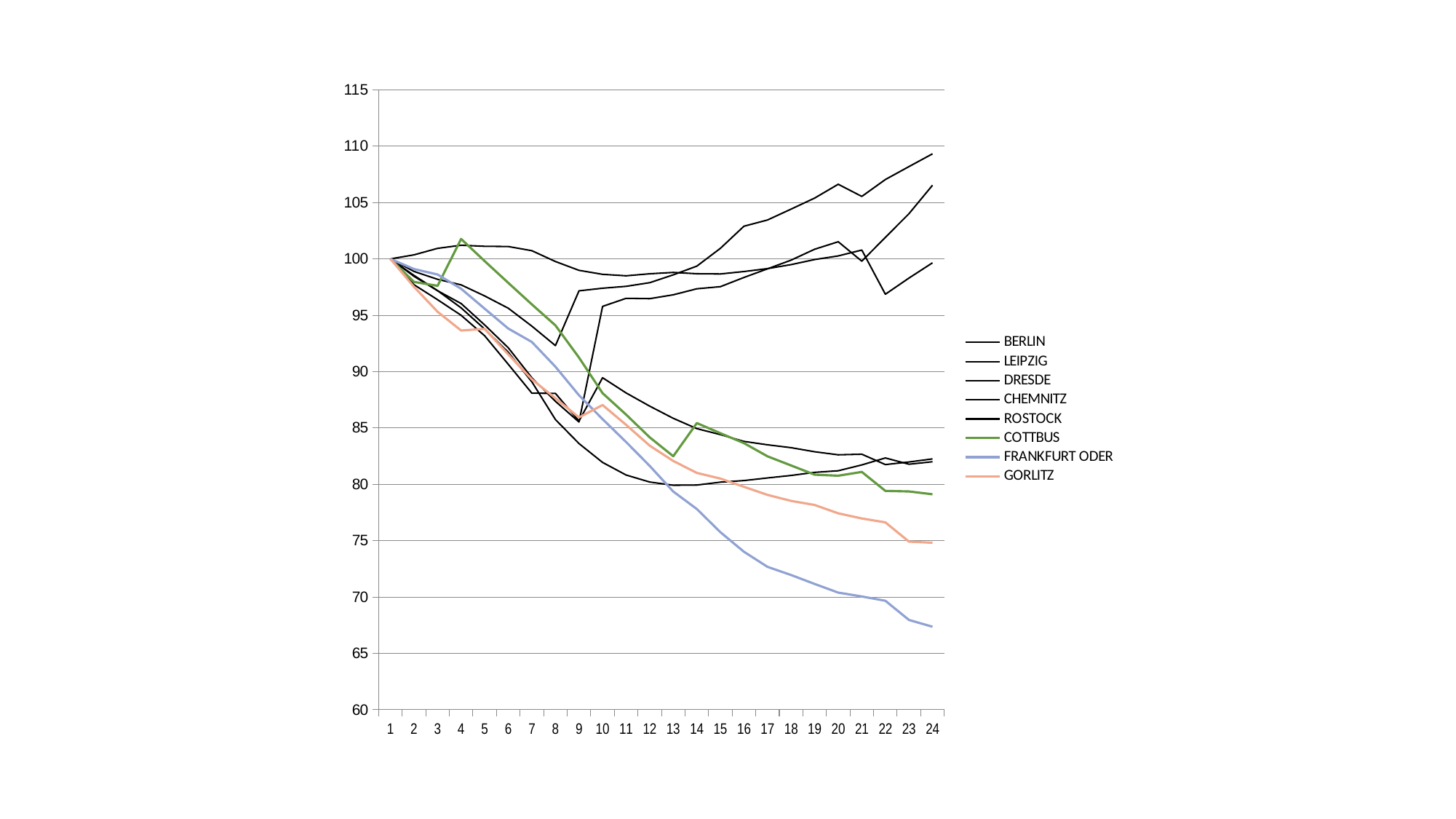
Is the value for FRANKFURT ODER at point 17 greater or less than 75? less Is the value for FRANKFURT ODER at point 24 greater or less than 70? less At point 24, which is larger: COTTBUS or FRANKFURT ODER? COTTBUS Which series is drawn with a green line? COTTBUS What kind of chart is shown on the slide? line chart How many points are there along the x axis? 24 Does the FRANKFURT ODER line rise or fall from point 1 to point 24? fall Which series has the lowest value at point 24? FRANKFURT ODER What value do all the series share at point 1 on the x axis? 100 Is the value for COTTBUS at point 4 greater or less than 100? greater How many series does the legend list? 8